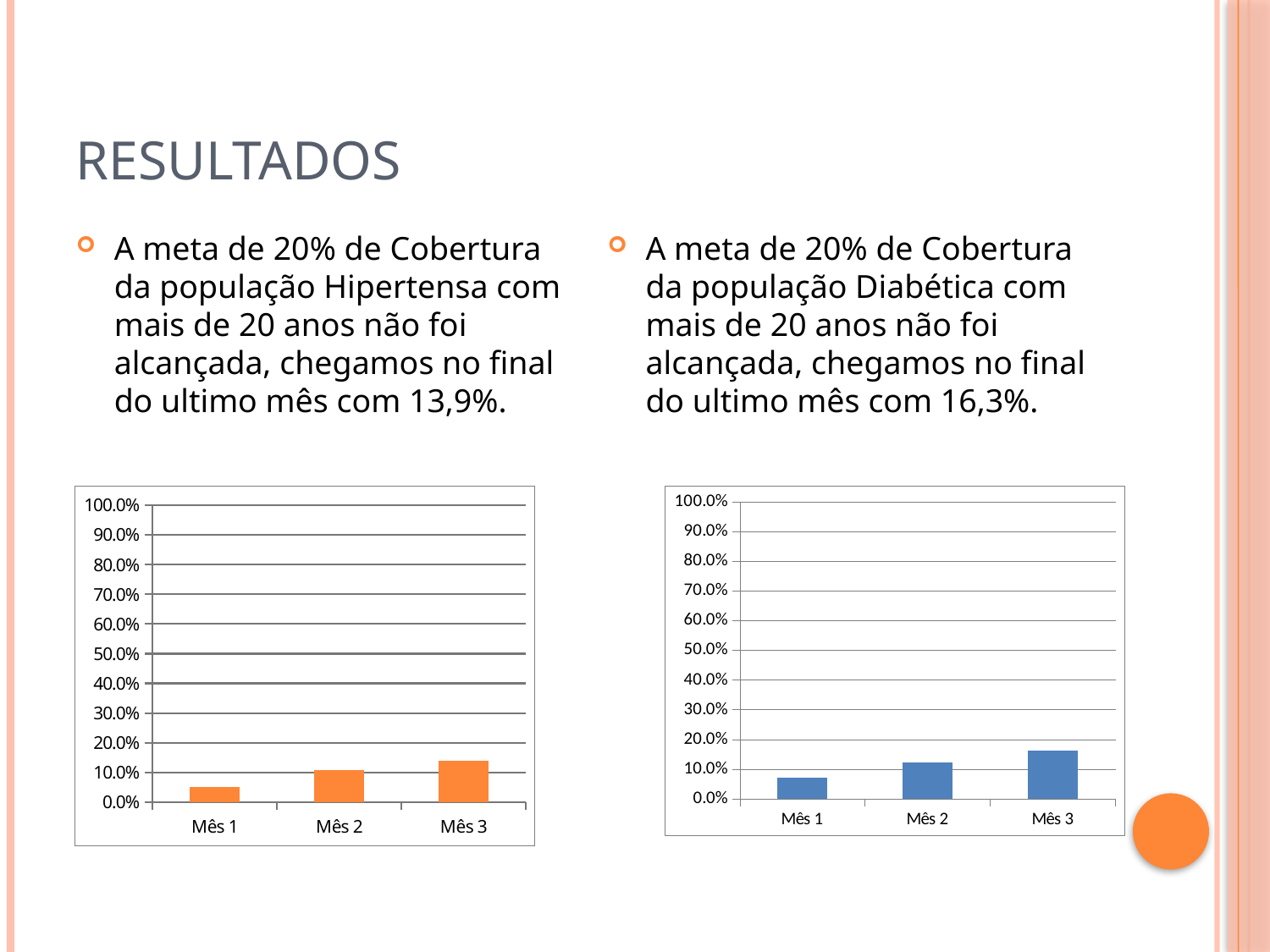
In the right chart, which month has the lowest bar? Mês 1 In the right chart, is the value for Mês 3 greater or less than 20.0%? less How many categories are shown on the x axis of the right chart? 3 In the left chart, which is larger, the value for Mês 1 or the value for Mês 2? Mês 2 In the left chart, which month has the lowest bar? Mês 1 In the left chart, is the value for Mês 1 greater or less than 10.0%? less What kind of chart is the left chart on the slide? bar chart In the right chart, is the value for Mês 2 greater or less than 10.0%? greater In the left chart, which month has the highest bar? Mês 3 Do the values in the right chart rise or fall from Mês 1 to Mês 3? rise In the right chart, which month has the highest bar? Mês 3